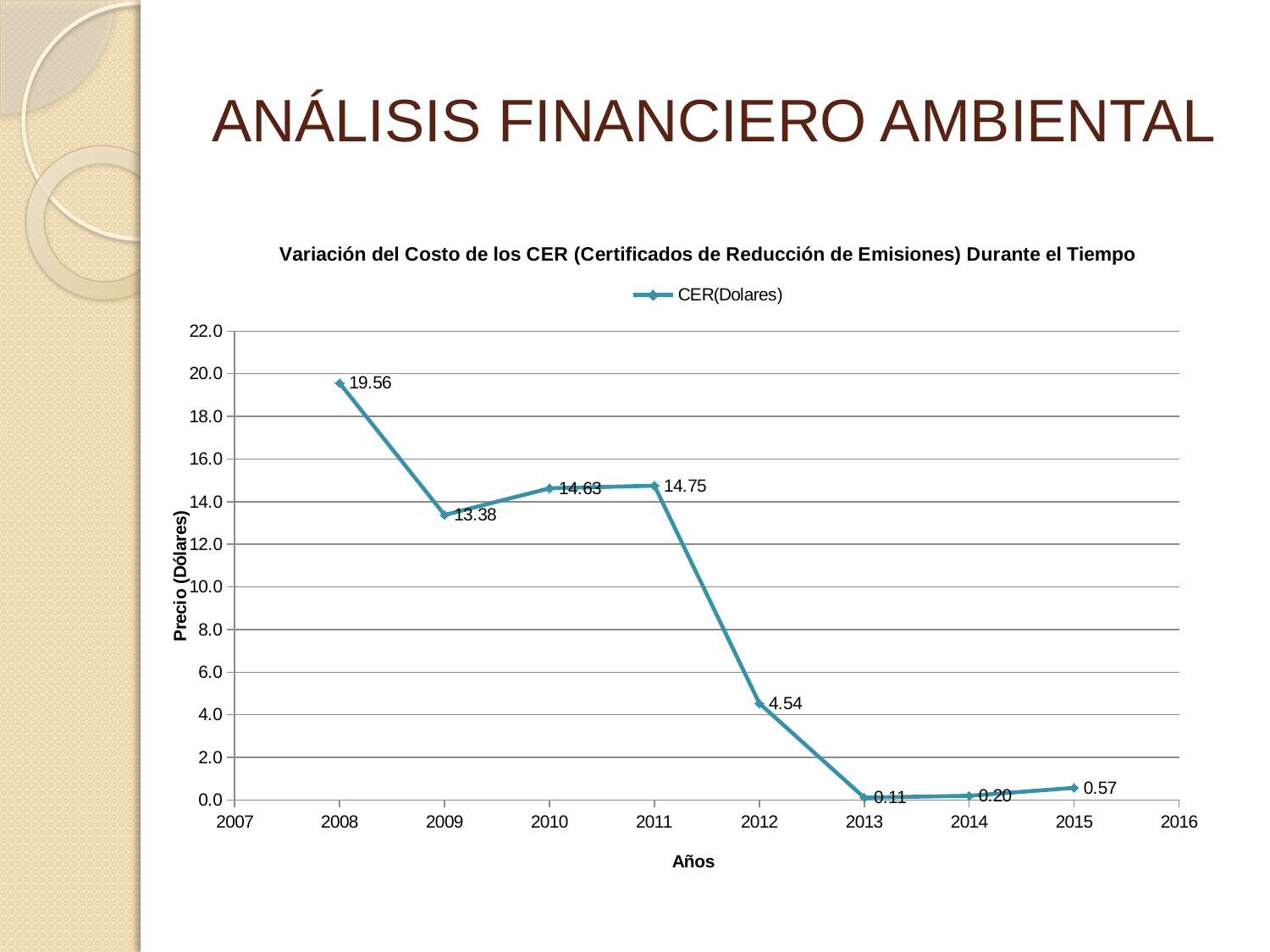
What is the label of the y axis? Precio (Dólares) Which year has a higher CER price, 2010 or 2012? 2010 What is the CER price in 2008? 19.56 In which year is the CER price lowest? 2013 What is the difference between the CER price in 2008 and in 2009? 6.18 Is the CER price in 2011 greater or less than 14.0? greater In which year is the CER price highest? 2008 How many data points are plotted on the line? 8 How many series does the legend list? 1 What is the CER price in 2015? 0.57 What kind of chart is shown on the slide? line chart What is the CER price in 2012? 4.54